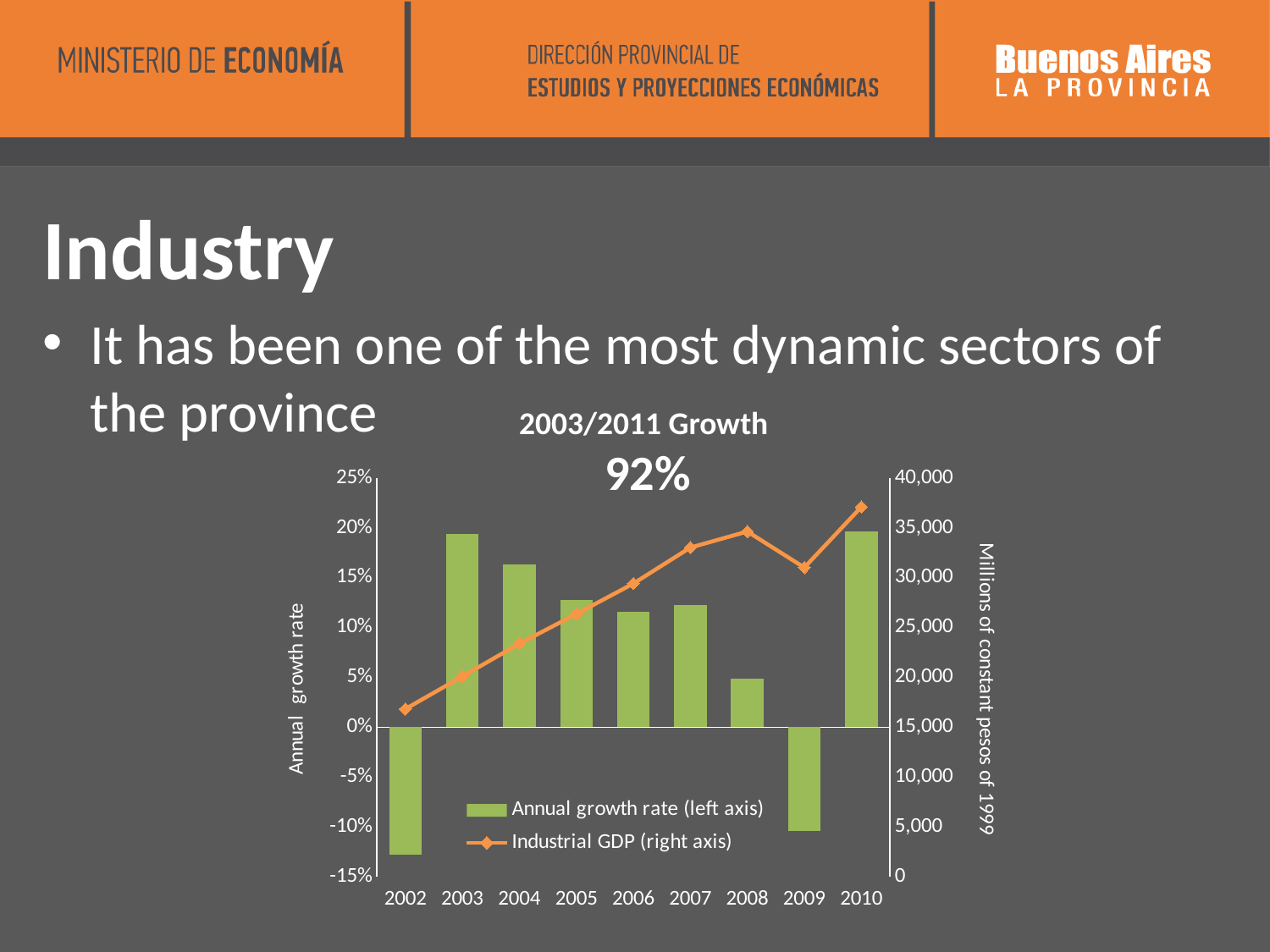
Is the Industrial GDP value for 2002 greater or less than 20,000? less Is the Industrial GDP value for 2010 greater or less than 35,000? greater Is the annual growth rate for 2003 greater or less than 15%? greater What growth figure is shown in the chart's title for 2003/2011? 92% Does Industrial GDP rise or fall from 2008 to 2009? fall What kind of chart is shown on the slide? Combined bar and line chart How many years are shown on the x axis of the chart? 9 How many series does the chart's legend list? 2 Which year has the larger annual growth rate, 2004 or 2008? 2004 Which year has the lowest annual growth rate? 2002 In which year is Industrial GDP highest? 2010